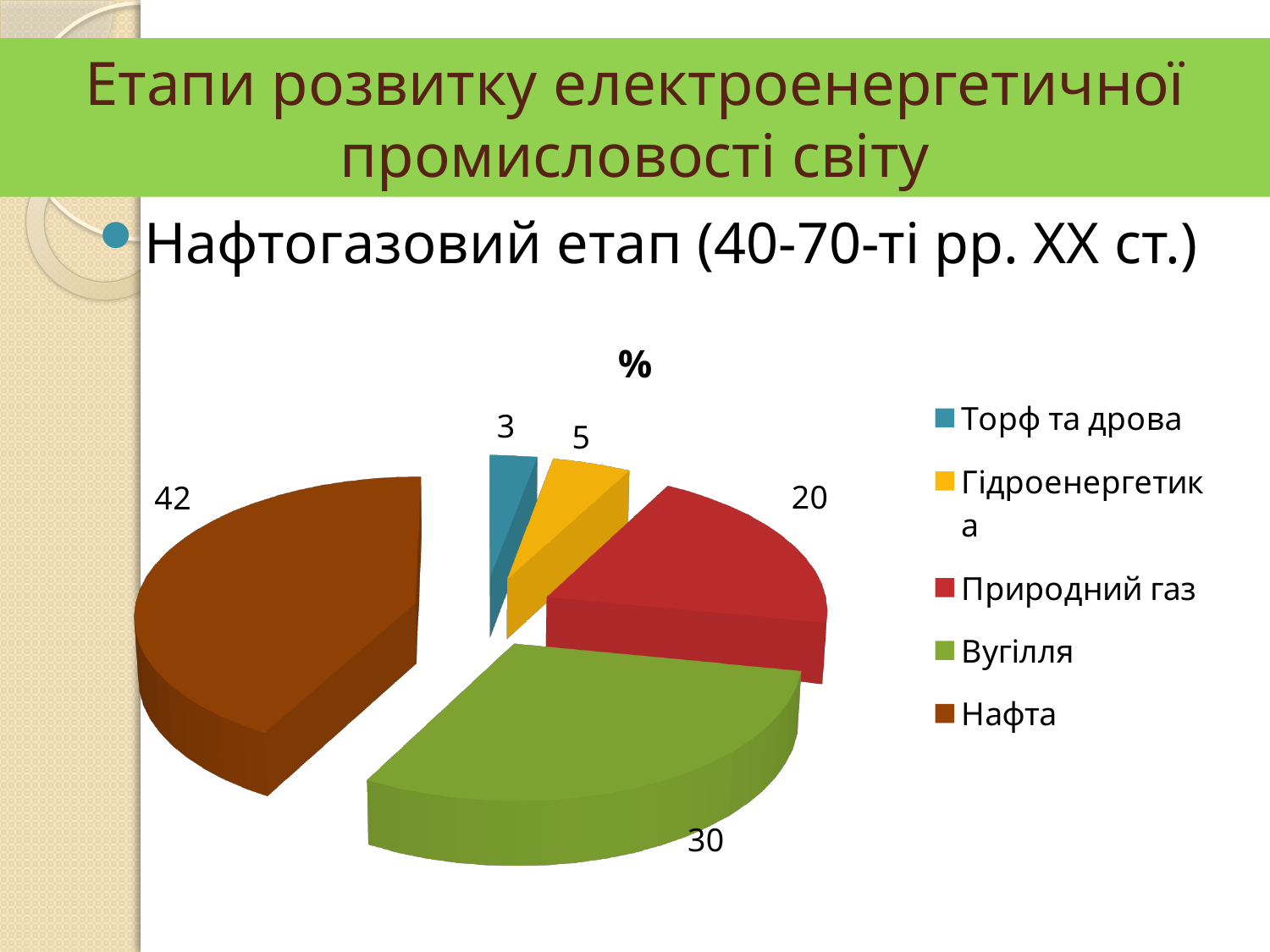
Which is larger, Природний газ or Гідроенергетика? Природний газ How many categories does the pie chart have? 5 What is the value for Вугілля? 30 What type of chart is shown on the slide? pie chart What is the title of the chart? % What is the value for Природний газ? 20 What is the value for Нафта? 42 Which category has the smallest slice? Торф та дрова What colour is the slice for Вугілля? green What is the difference between the values for Нафта and Вугілля? 12 Which category has the largest slice? Нафта What is the value for Торф та дрова? 3